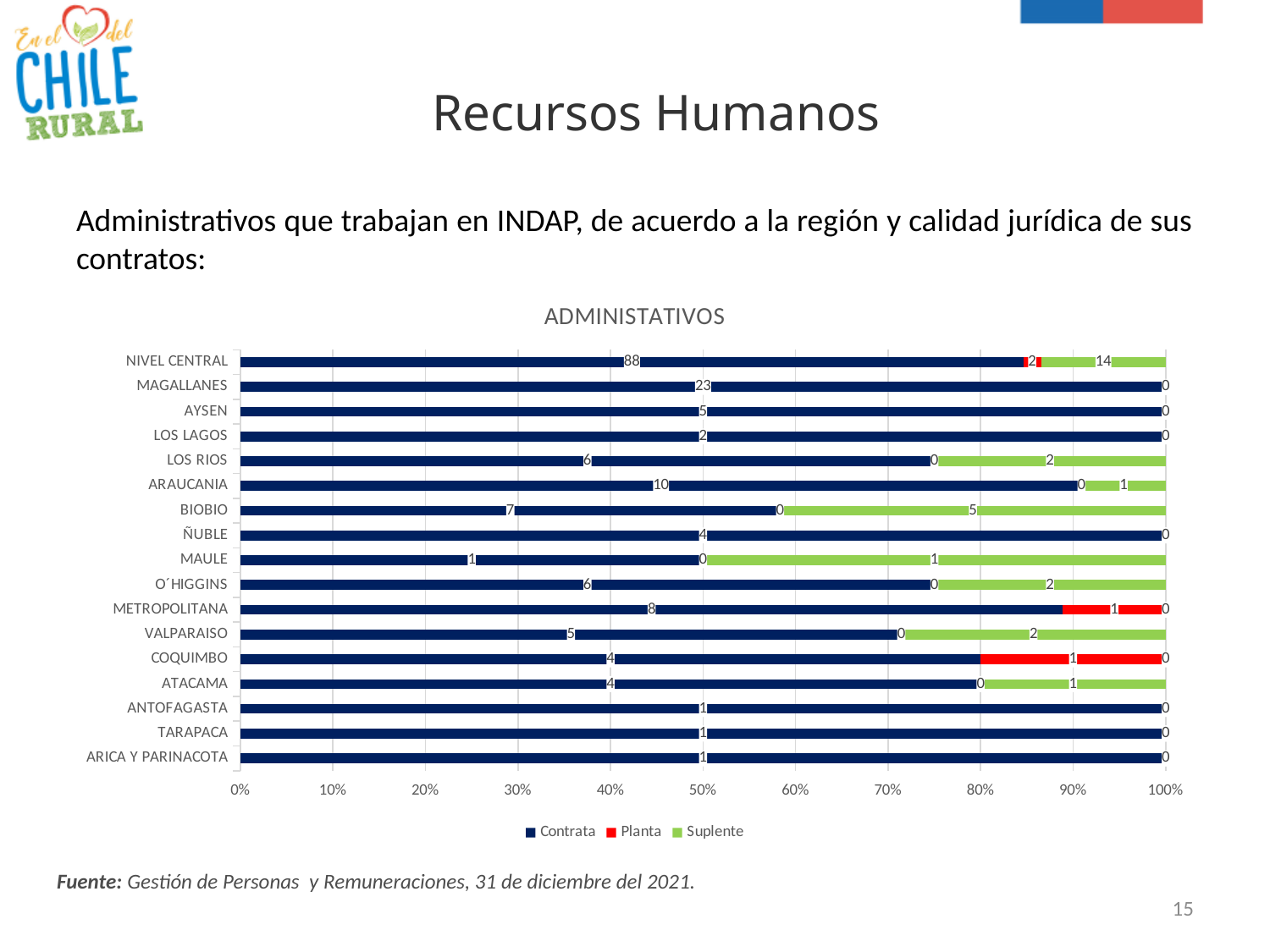
What is the difference between the Contrata and Suplente values for NIVEL CENTRAL? 74 What is the Contrata value for MAGALLANES? 23 How many regions are listed on the chart? 17 What is the Planta value for METROPOLITANA? 1 What is the Contrata value for NIVEL CENTRAL? 88 What kind of chart is shown on the slide? Stacked bar chart What is the Suplente value for BIOBIO? 5 How many series does the legend list? 3 What is the Contrata value for ARAUCANIA? 10 Which has the larger Contrata value, BIOBIO or LOS RIOS? BIOBIO Which region has the highest Contrata value? NIVEL CENTRAL What is the Suplente value for NIVEL CENTRAL? 14